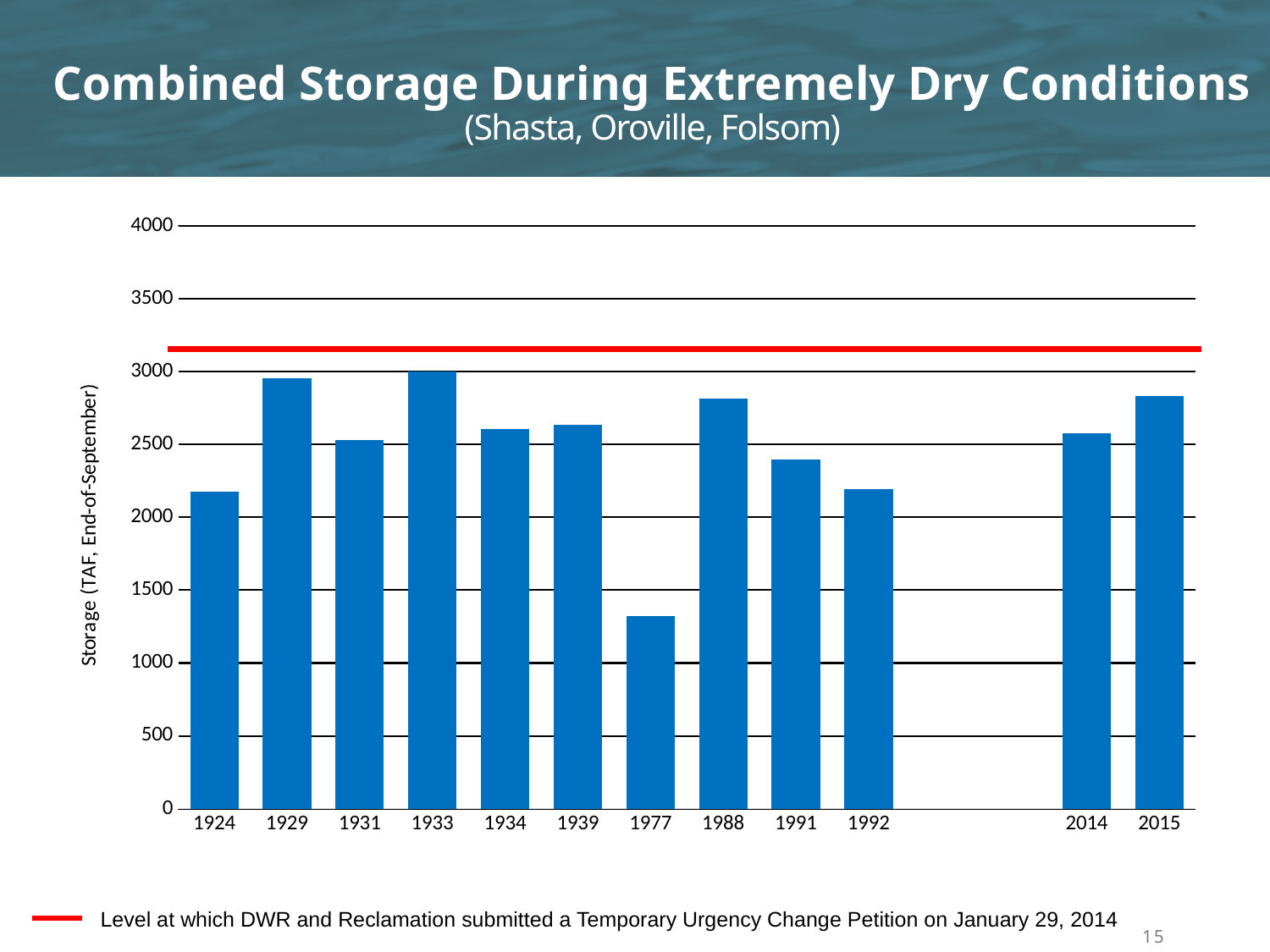
How many years (bars) are plotted in the chart? 12 Is the combined storage for 1991 greater or less than 2500? less Which year has the lowest combined storage? 1977 Which year has the larger combined storage, 1977 or 1988? 1988 Which year has the larger combined storage, 2014 or 2015? 2015 What is the label on the vertical axis of the chart? Storage (TAF, End-of-September) Which year has the larger combined storage, 1991 or 1992? 1991 Is the combined storage for 1988 greater or less than 2500? greater Is the combined storage for 2015 greater or less than 2500? greater What kind of chart is shown on the slide? bar chart